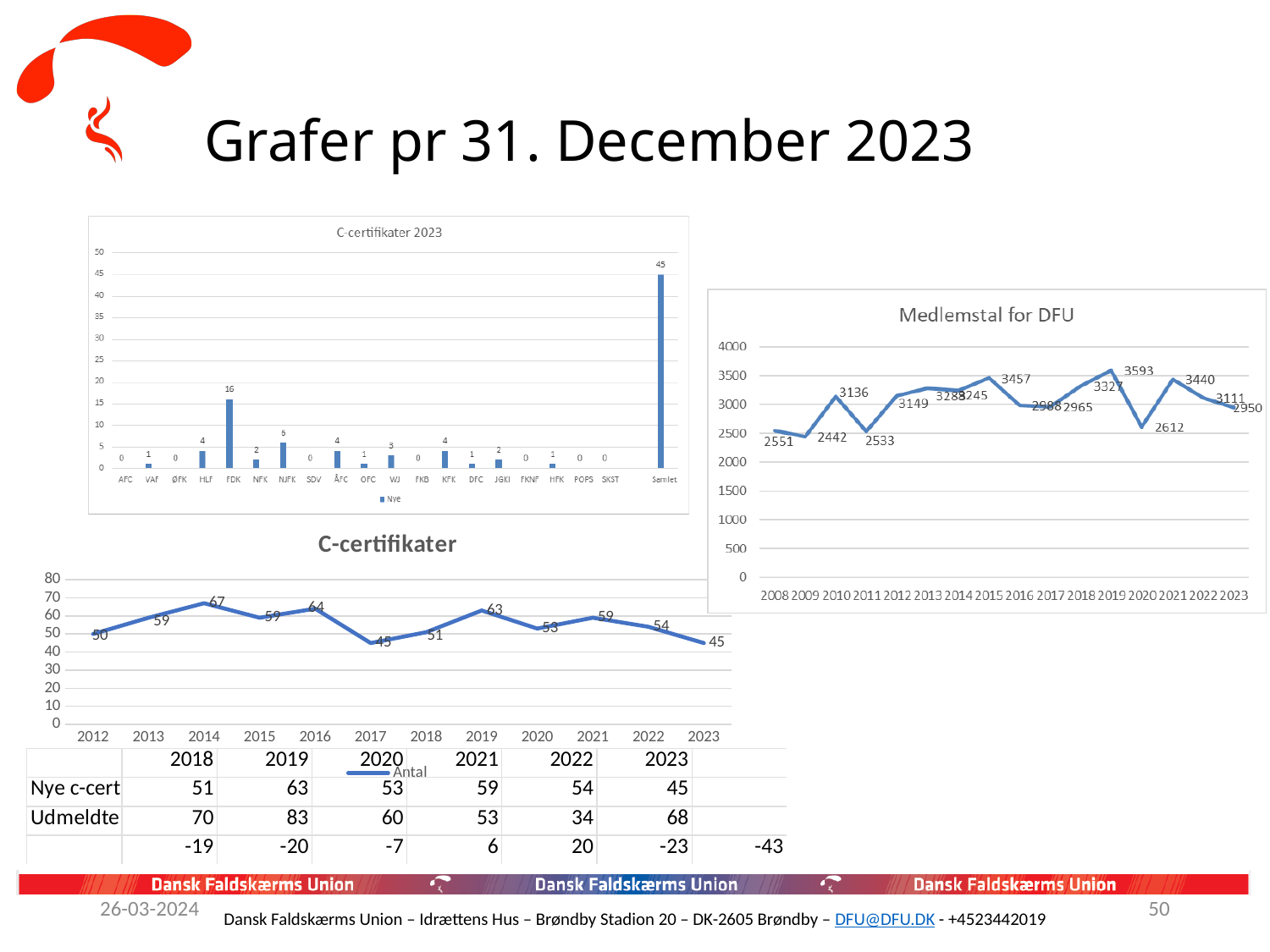
What kind of chart is the 'C-certifikater 2023' chart? bar chart In the 'Medlemstal for DFU' chart, what is the difference between the values for 2019 and 2020? 981 In the 'Medlemstal for DFU' chart, which year has the highest value? 2019 In the 'C-certifikater' line chart, what is the value for 2017? 45 In the 'Medlemstal for DFU' chart, is the value for 2015 greater or less than 3000? greater How many years are plotted in the 'C-certifikater' line chart? 12 In the 'Medlemstal for DFU' chart, what is the value for 2023? 2950 In the 'C-certifikater' line chart, which year has the highest value? 2014 In the 'C-certifikater 2023' chart, what is the value for FDK? 16 In the 'C-certifikater 2023' chart, what is the name of the series shown in the legend? Nye In the 'Medlemstal for DFU' chart, which year has the lowest value? 2009 In the 'C-certifikater 2023' chart, what is the value for Samlet? 45